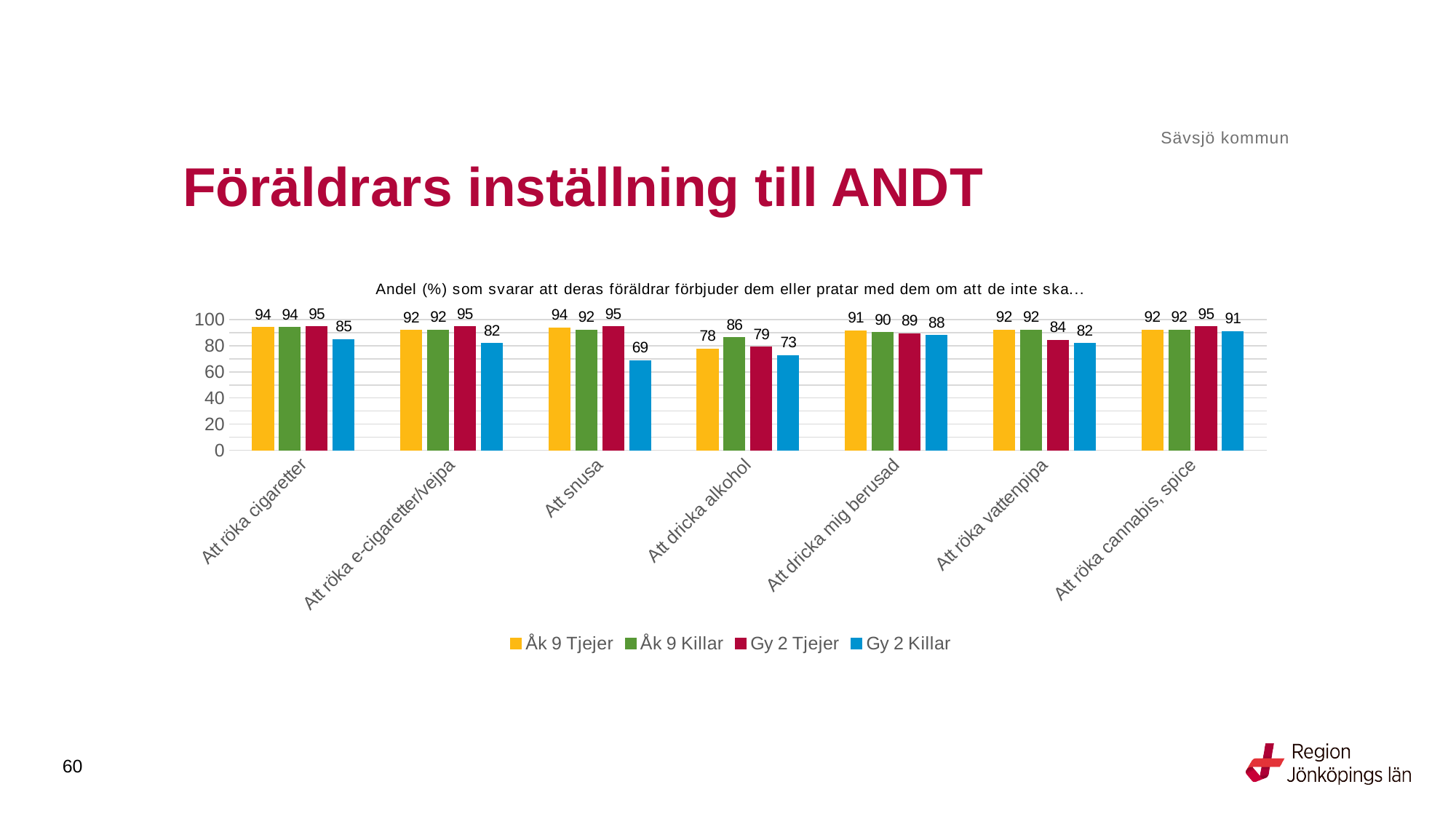
How many series does the legend list? 4 What is the total of the four series values in the category "Att dricka mig berusad"? 358 Which category has the lowest value for Gy 2 Killar? Att snusa What kind of chart is shown on the slide? Bar chart What is the value for Gy 2 Killar in the category "Att snusa"? 69 Which is larger in the category "Att dricka alkohol": the value for Åk 9 Killar or the value for Gy 2 Tjejer? Åk 9 Killar Which category has the lowest value for Åk 9 Tjejer? Att dricka alkohol Which series is shown in blue in the legend? Gy 2 Killar How many categories are shown on the x axis? 7 What is the value for Gy 2 Tjejer in the category "Att röka vattenpipa"? 84 What is the difference between the Gy 2 Tjejer and Gy 2 Killar values in the category "Att snusa"? 26 What is the value for Åk 9 Tjejer in the category "Att dricka alkohol"? 78